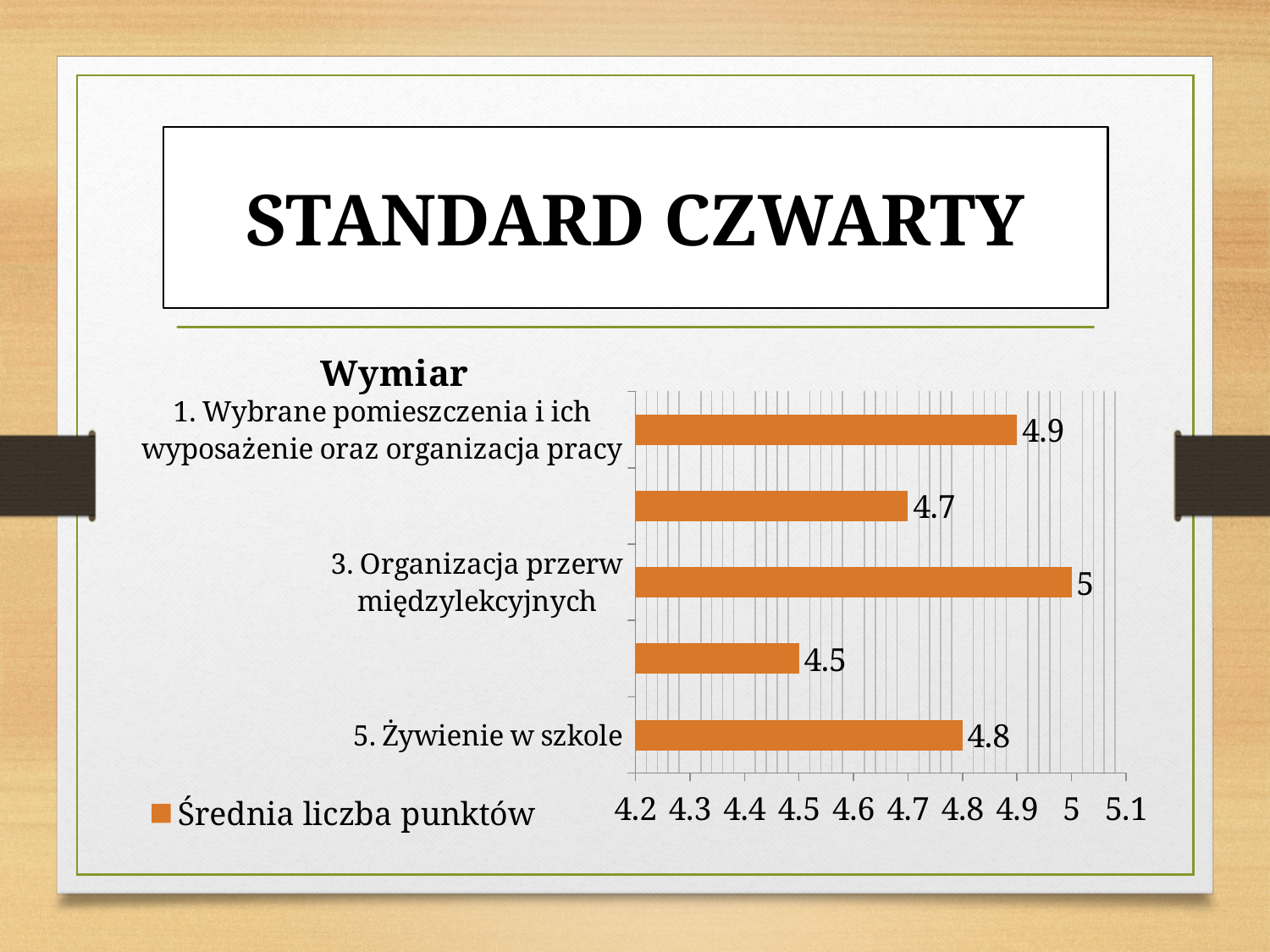
How many series does the legend list? 1 What is the difference between the values for "3. Organizacja przerw międzylekcyjnych" and "5. Żywienie w szkole"? 0.2 What is the value for "5. Żywienie w szkole"? 4.8 How many bars are plotted on the chart? 5 What is the lowest value shown on the chart? 4.5 What is the difference between the values for "1. Wybrane pomieszczenia i ich wyposażenie oraz organizacja pracy" and "5. Żywienie w szkole"? 0.1 What kind of chart is shown on the slide? bar chart Which category has the highest value? 3. Organizacja przerw międzylekcyjnych What is the value for "1. Wybrane pomieszczenia i ich wyposażenie oraz organizacja pracy"? 4.9 What is the value for "3. Organizacja przerw międzylekcyjnych"? 5 Which is larger: the value for "1. Wybrane pomieszczenia i ich wyposażenie oraz organizacja pracy" or the value for "5. Żywienie w szkole"? 1. Wybrane pomieszczenia i ich wyposażenie oraz organizacja pracy What is the name of the series shown in the legend? Średnia liczba punktów